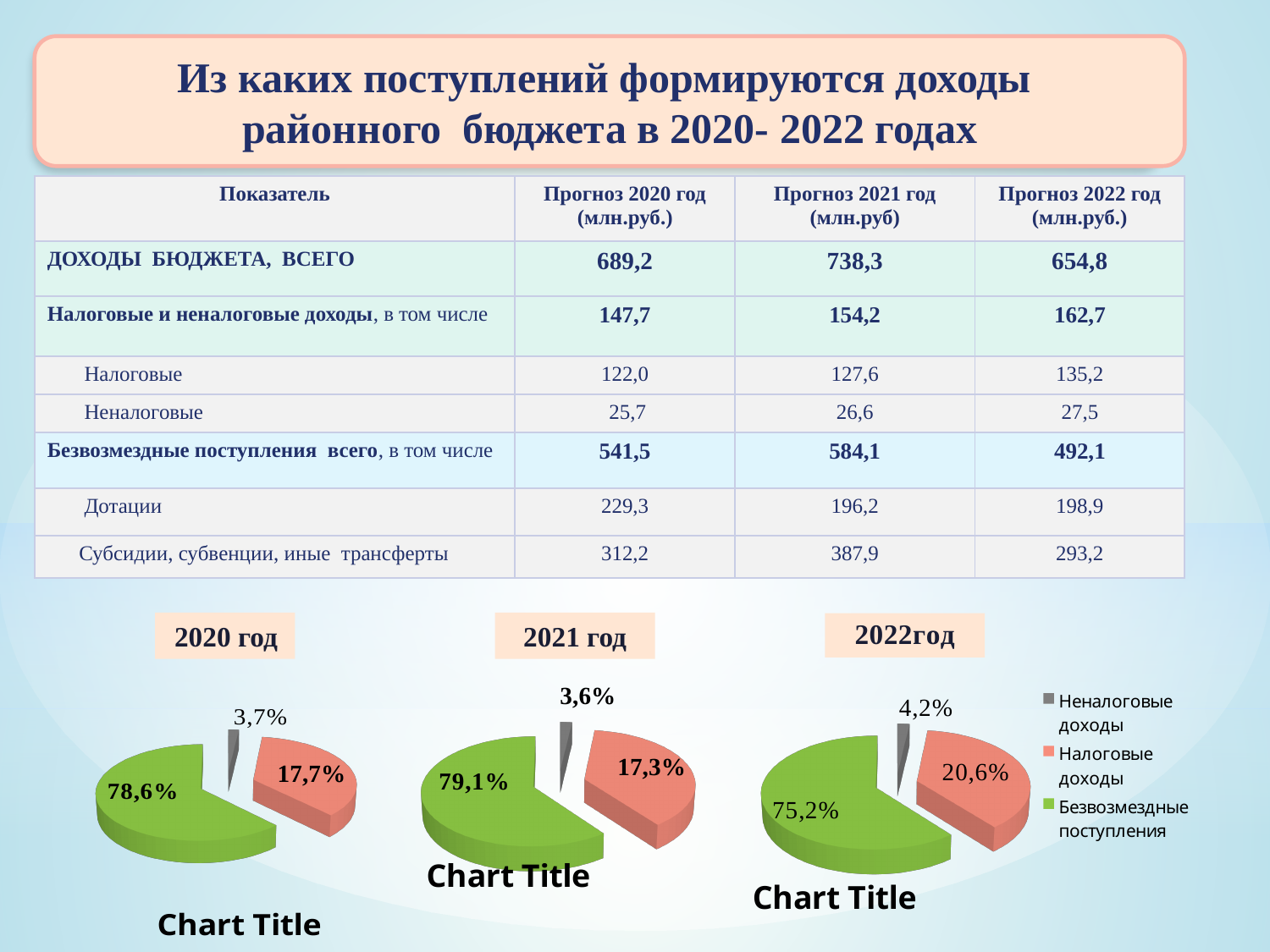
What colour represents Безвозмездные поступления in the pie charts? Green In the 2022год pie chart, what is the combined share of Налоговые доходы and Неналоговые доходы? 24,8% In the 2020 год pie chart, which category has the smallest slice? Неналоговые доходы In the 2022год pie chart, what share is shown for Неналоговые доходы? 4,2% In the 2021 год pie chart, what share is shown for Налоговые доходы? 17,3% How many entries does the legend on the right list? 3 In the 2020 год pie chart, what share is shown for Безвозмездные поступления? 78,6% In the 2021 год pie chart, what is the difference between the shares of Безвозмездные поступления and Налоговые доходы? 61,8% How many slices does the 2021 год pie chart have? 3 What type of chart is used for the 2020 год data? Pie chart Which is larger: the Налоговые доходы share in the 2022год pie chart or in the 2020 год pie chart? 2022год In the 2022год pie chart, which category has the largest slice? Безвозмездные поступления